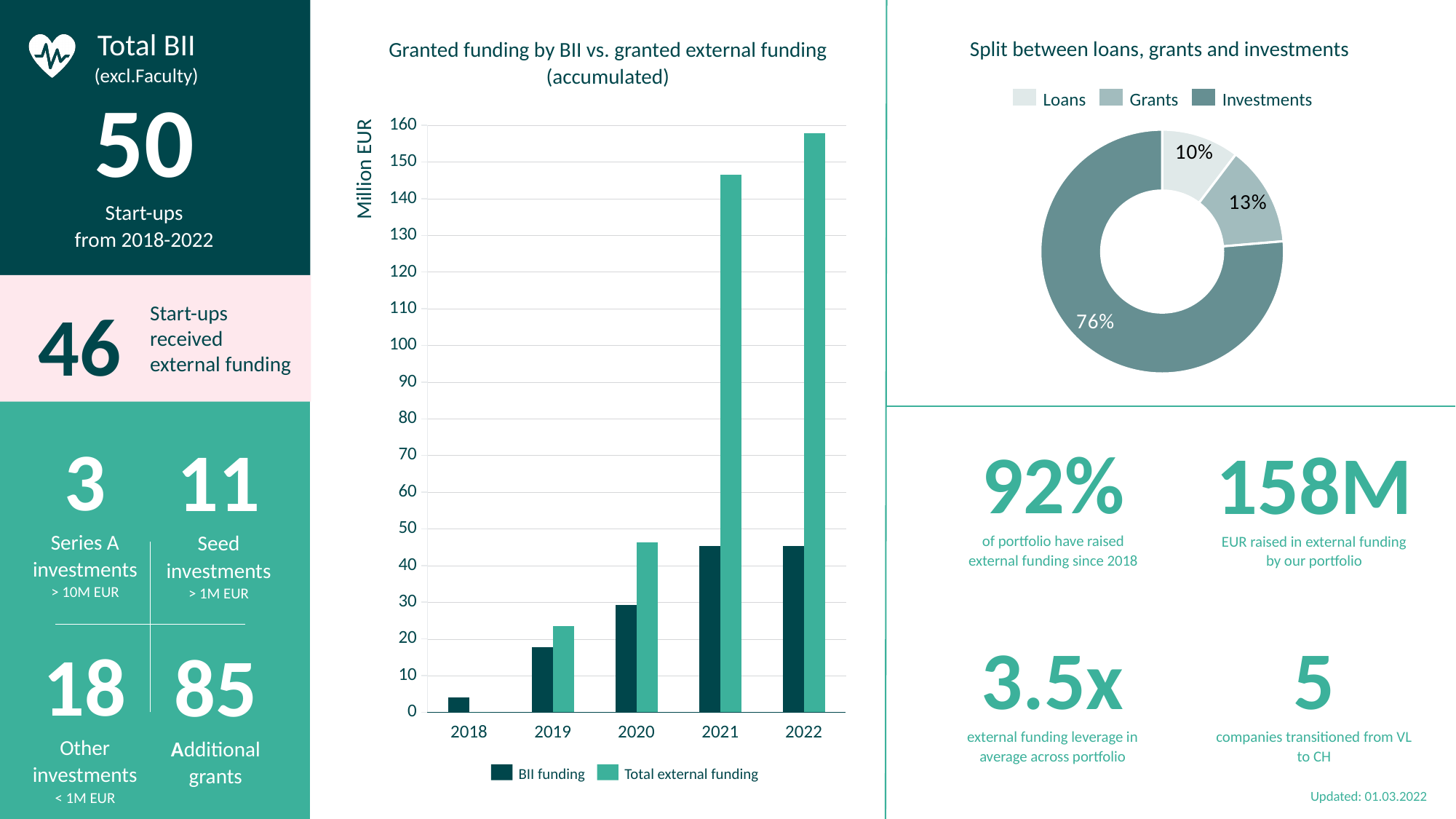
In the 'Split between loans, grants and investments' chart, what is the difference between the Grants share and the Loans share? 3% In the 'Granted funding by BII vs. granted external funding (accumulated)' chart, is the Total external funding value for 2022 greater or less than 150? greater In the 'Granted funding by BII vs. granted external funding (accumulated)' chart, what unit is shown on the y axis? Million EUR In the 'Granted funding by BII vs. granted external funding (accumulated)' chart, what kind of chart is shown? bar chart In the 'Granted funding by BII vs. granted external funding (accumulated)' chart, does Total external funding rise or fall from 2018 to 2022? rise In the 'Granted funding by BII vs. granted external funding (accumulated)' chart, how many series does the legend list? 2 In the 'Granted funding by BII vs. granted external funding (accumulated)' chart, which year has the lowest BII funding? 2018 In the 'Granted funding by BII vs. granted external funding (accumulated)' chart, is the BII funding value for 2021 greater or less than 50? less In the 'Granted funding by BII vs. granted external funding (accumulated)' chart, which year has the highest Total external funding? 2022 In the 'Granted funding by BII vs. granted external funding (accumulated)' chart, how many years are shown on the x axis? 5 In the 'Split between loans, grants and investments' chart, what share do Investments have? 76% In the 'Granted funding by BII vs. granted external funding (accumulated)' chart, which is larger in 2020: BII funding or Total external funding? Total external funding